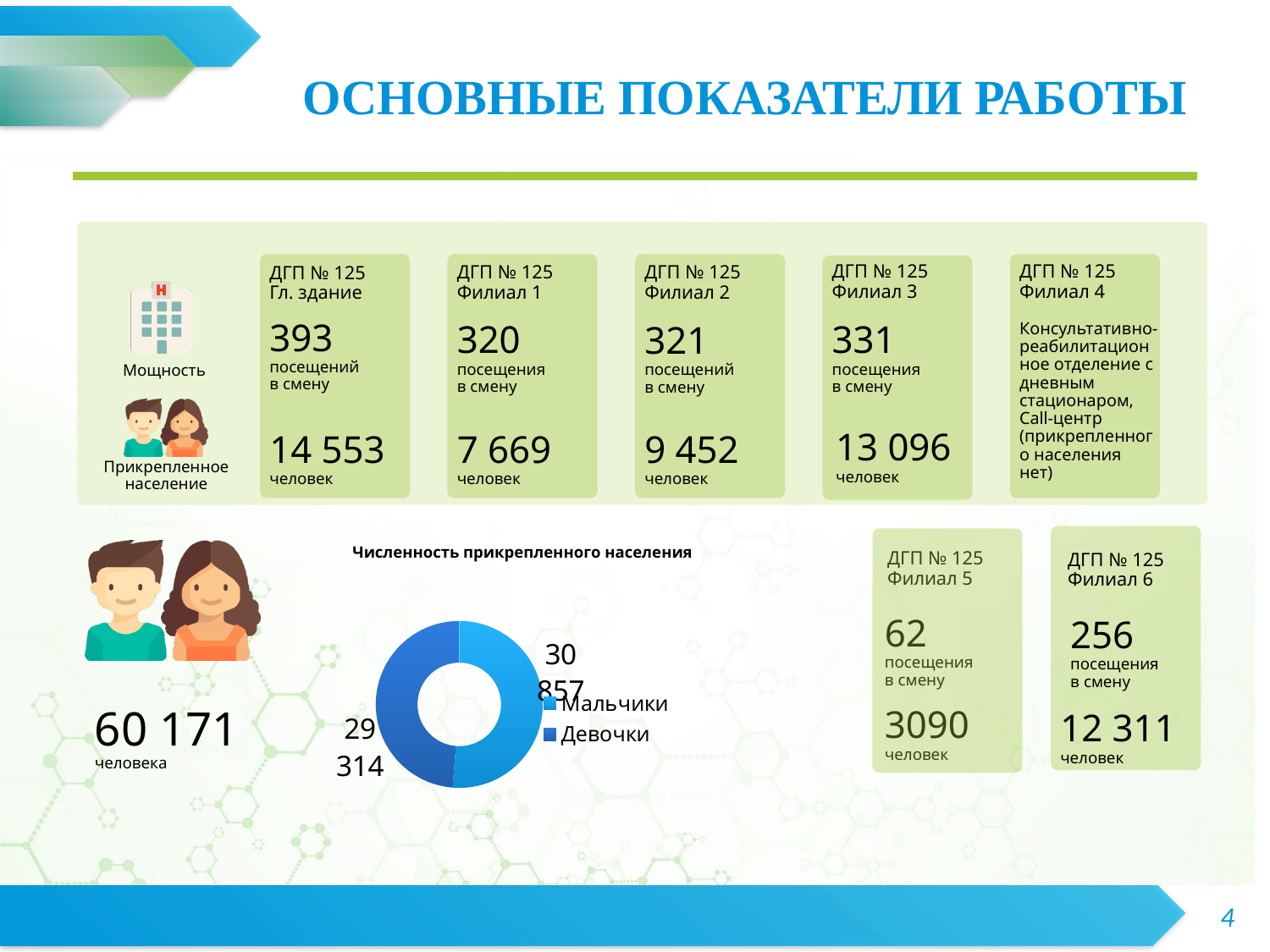
In the chart "Численность прикрепленного населения", what is the difference between the values for Мальчики and Девочки? 1 543 How many categories (slices) does the chart "Численность прикрепленного населения" have? 2 What is the total of the two slices in the chart "Численность прикрепленного населения"? 60 171 What is the title of the doughnut chart on the slide? Численность прикрепленного населения What kind of chart is shown under the title "Численность прикрепленного населения"? Doughnut (pie) chart In the chart "Численность прикрепленного населения", what is the value for Мальчики? 30 857 In the chart "Численность прикрепленного населения", which category has the smaller value? Девочки In the chart "Численность прикрепленного населения", what is the value for Девочки? 29 314 In the chart "Численность прикрепленного населения", is the value for Мальчики larger or smaller than the value for Девочки? larger In the chart "Численность прикрепленного населения", which legend entry is listed first? Мальчики In the chart "Численность прикрепленного населения", which category has the larger value? Мальчики How many entries does the legend of the chart "Численность прикрепленного населения" list? 2